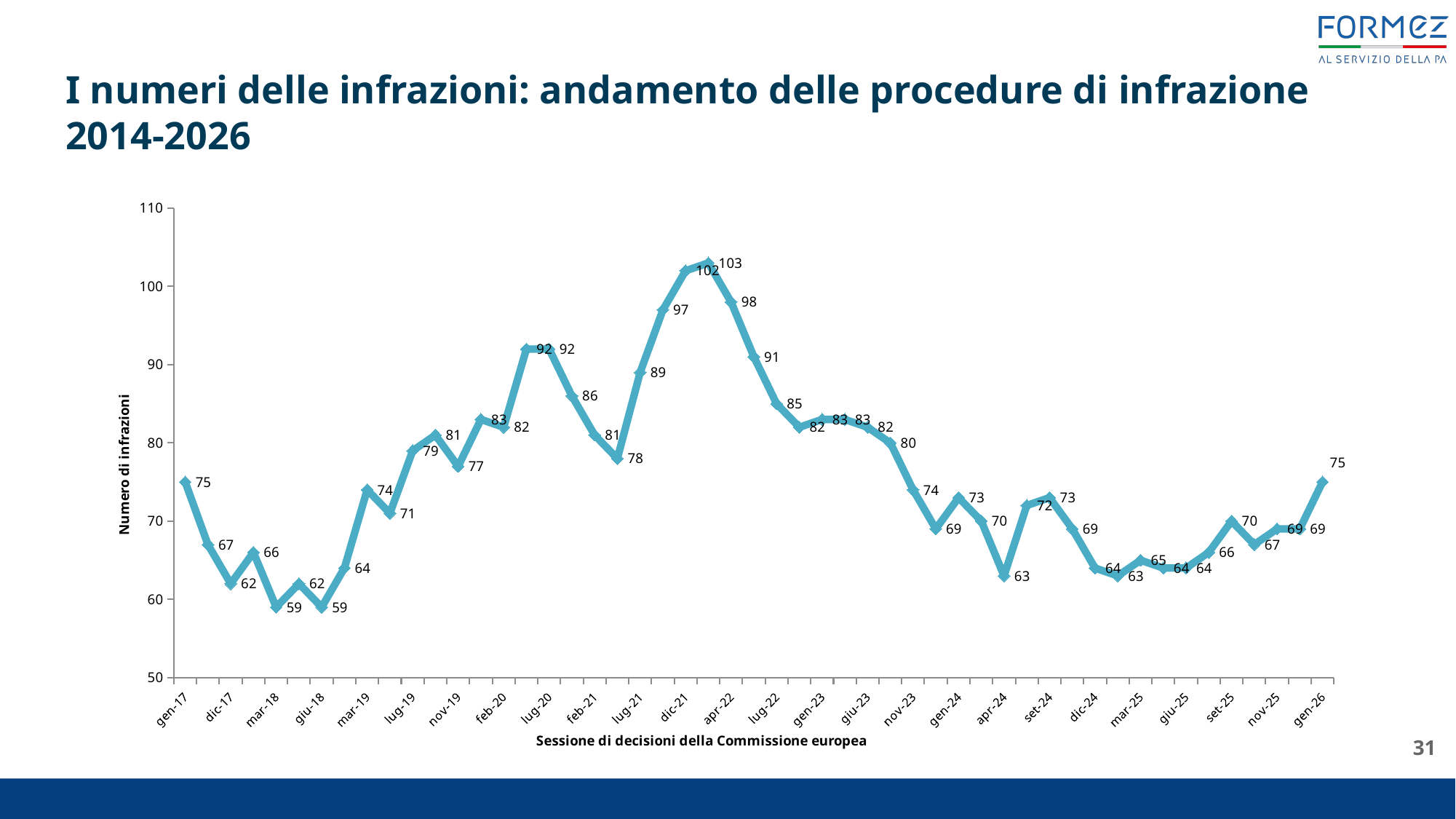
What is the title of the vertical axis? Numero di infrazioni What is the lowest number of infractions shown on the chart? 59 Does the line rise or fall overall between apr-24 and gen-26? rise Is the peak value of the line greater or less than 100? greater How many lines (series) are plotted on the chart? 1 What is the difference between the highest value (103) and the lowest value (59) on the chart? 44 What is the title of the horizontal axis? Sessione di decisioni della Commissione europea What kind of chart is shown on the slide? line chart What is the number of infractions at gen-26, the last point on the chart? 75 What is the highest number of infractions shown on the chart? 103 What is the number of infractions at gen-17, the first point on the chart? 75 Does the line rise or fall between gen-17 and giu-18? fall